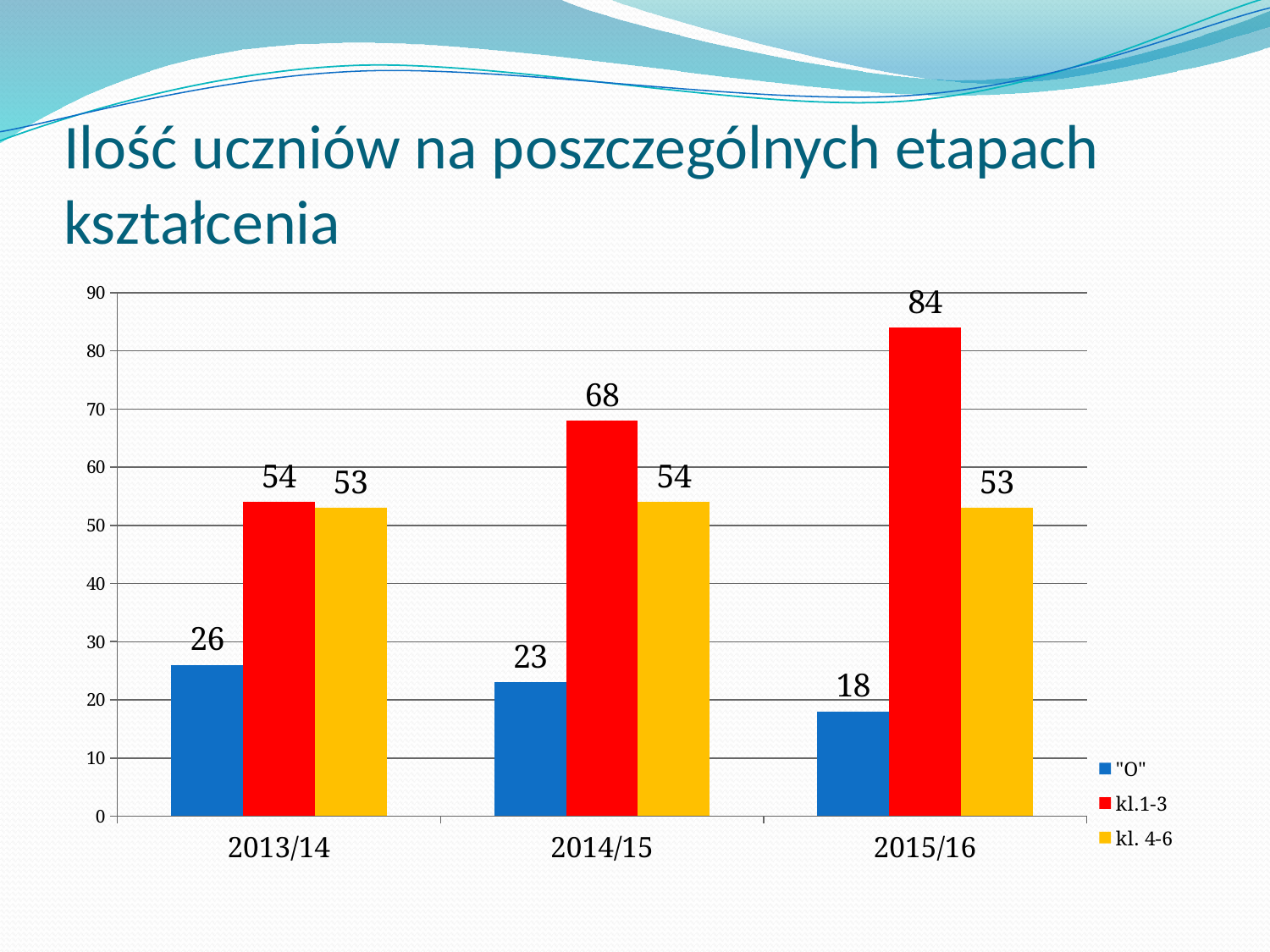
What is the value for "O" in 2013/14? 26 What is the value for kl.1-3 in 2015/16? 84 In which school year is the kl.1-3 value highest? 2015/16 How many school years are shown on the x axis? 3 Is the value for "O" in 2014/15 greater or less than 30? less Which is larger in 2014/15: kl.1-3 or kl. 4-6? kl.1-3 How many series does the legend list? 3 What kind of chart is shown on the slide? bar chart Does the "O" series rise or fall from 2013/14 to 2015/16? fall What is the value for kl. 4-6 in 2014/15? 54 What is the difference between the kl.1-3 values for 2015/16 and 2013/14? 30 In which school year is the "O" value lowest? 2015/16